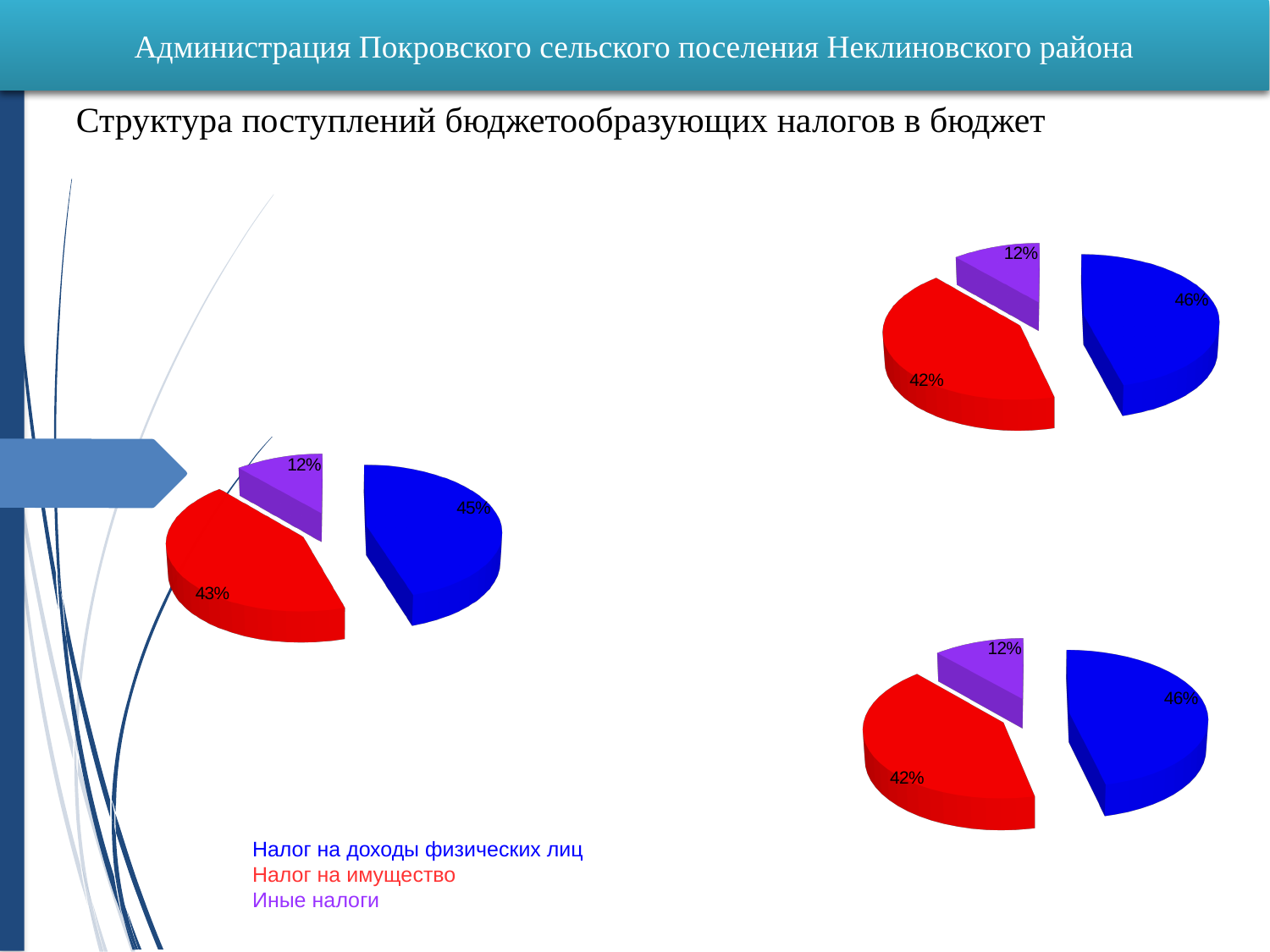
In the top-right pie chart, what share does Налог на доходы физических лиц have? 46% In the bottom-right pie chart, what share does Иные налоги have? 12% In the pie chart on the left, what share does the blue slice (Налог на доходы физических лиц) have? 45% In the top-right pie chart, what is the difference between the shares of Налог на доходы физических лиц and Налог на имущество? 4% How many categories does the legend list? 3 What kind of chart is the chart on the left of the slide? pie chart In the pie chart on the left, which category has the smallest share? Иные налоги In the bottom-right pie chart, which category has the largest share? Налог на доходы физических лиц How many pie charts are shown on the slide? 3